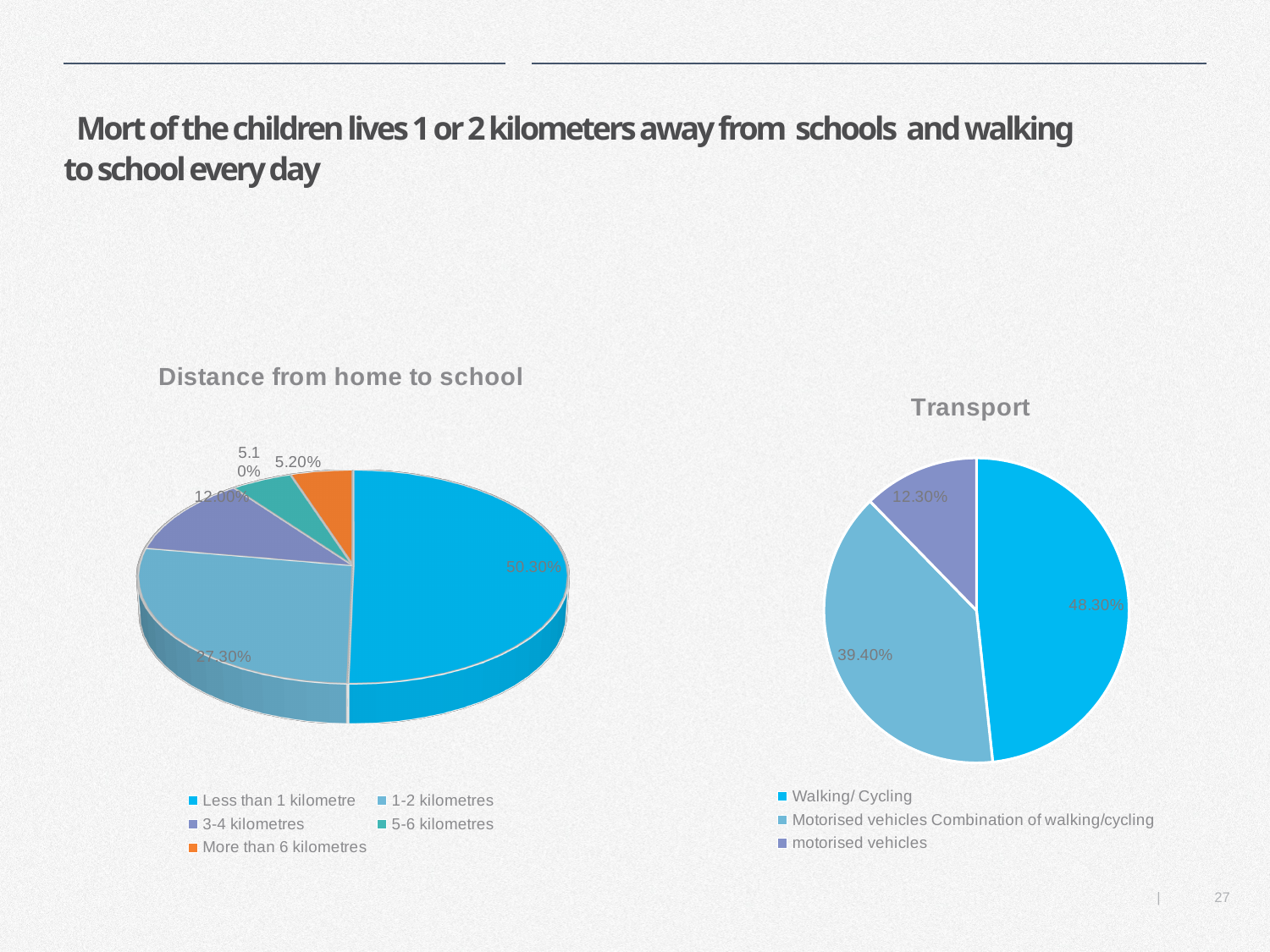
In the 'Transport' chart, what is the difference between the 'Walking/ Cycling' share and the 'Motorised vehicles Combination of walking/cycling' share? 8.90% In the 'Transport' chart, which category has the smallest slice? motorised vehicles In the 'Transport' chart, which is larger: 'Walking/ Cycling' or 'Motorised vehicles Combination of walking/cycling'? Walking/ Cycling In the 'Transport' chart, what share is shown for 'Walking/ Cycling'? 48.30% In the 'Distance from home to school' chart, what share is shown for '1-2 kilometres'? 27.30% How many categories does the legend of the 'Distance from home to school' chart list? 5 In the 'Distance from home to school' chart, what share is shown for '3-4 kilometres'? 12.00% In the 'Distance from home to school' chart, which category has the largest slice? Less than 1 kilometre What kind of chart is the 'Distance from home to school' chart? pie chart In the 'Distance from home to school' chart, what share is shown for 'Less than 1 kilometre'? 50.30% In the 'Transport' chart, what share is shown for 'motorised vehicles'? 12.30% In the 'Distance from home to school' chart, what is the difference between the 'Less than 1 kilometre' and '1-2 kilometres' shares? 23.00%